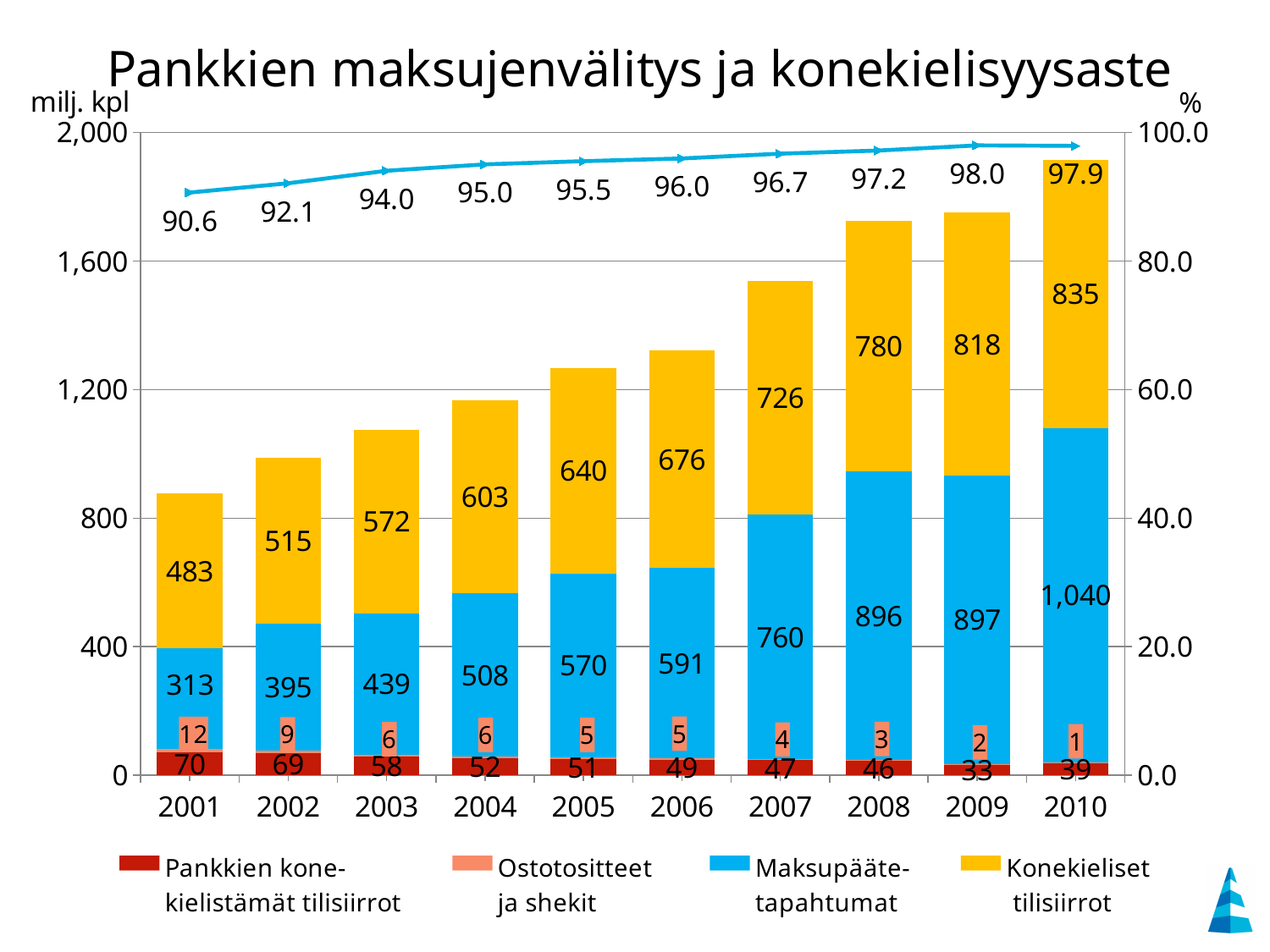
What is the value of Konekieliset tilisiirrot in 2010? 835 What is the konekielisyysaste (line) value shown for 2001? 90.6 What is the value of Pankkien konekielistämät tilisiirrot in 2009? 33 How many series does the legend list? 4 What is the total of the stacked bar for 2001? 878 In which year is Maksupäätetapahtumat highest? 2010 How many years are shown on the x axis? 10 In which year is Ostotositteet ja shekit lowest? 2010 How much larger is Konekieliset tilisiirrot in 2010 than in 2001? 352 What kind of chart is used for the milj. kpl values? bar chart What is the value of Maksupäätetapahtumat in 2007? 760 In 2008, which is larger: Maksupäätetapahtumat or Konekieliset tilisiirrot? Maksupäätetapahtumat